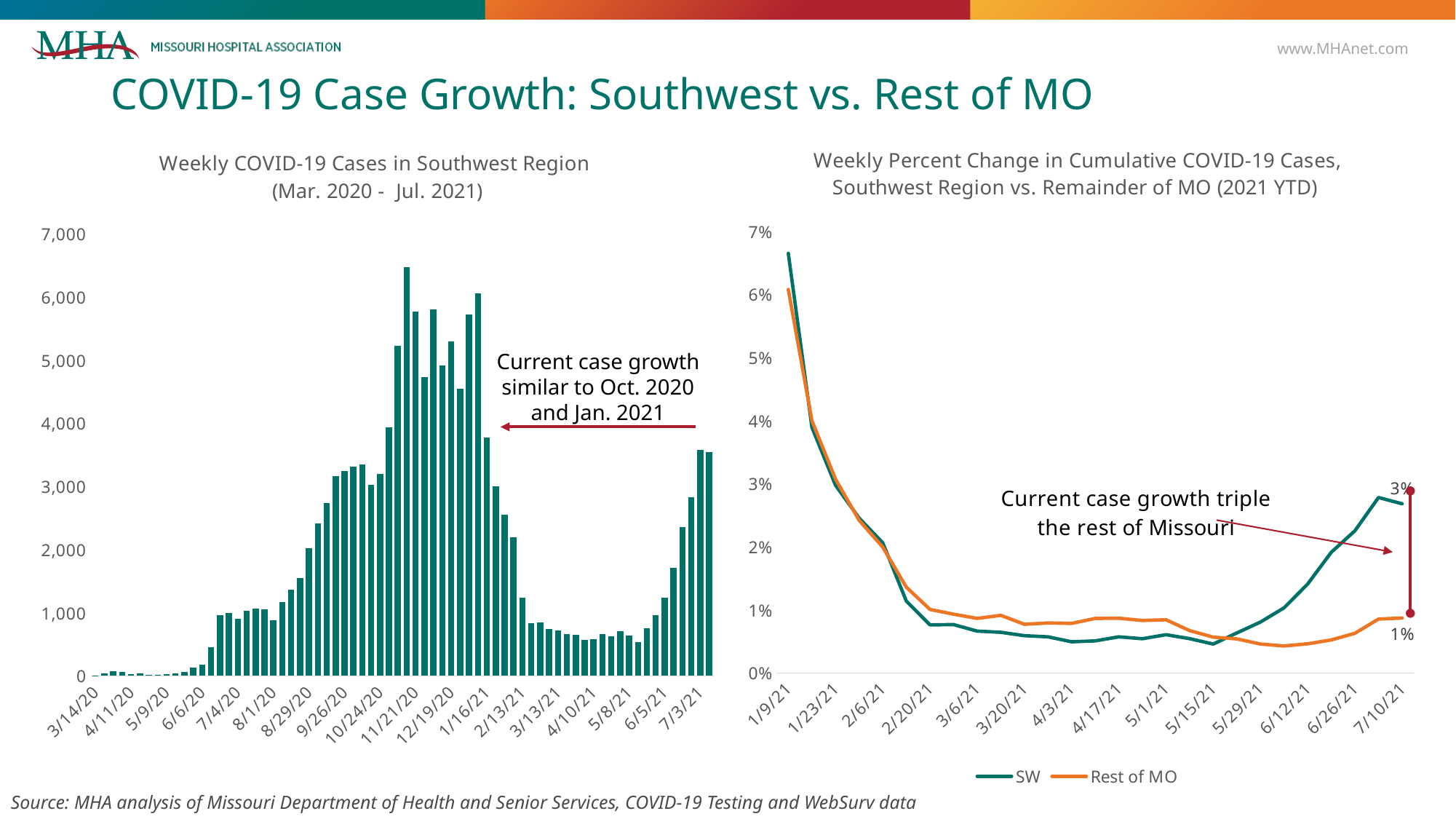
In the left chart, is the tallest bar greater or less than 6,000? greater In the right chart, what is the labeled value for Rest of MO at 7/10/21? 1% In the right chart, is the SW value at 1/9/21 greater or less than 6%? greater In the right chart, what are the two series named in the legend? SW and Rest of MO In the right chart, what is the labeled value for SW at 7/10/21? 3% In the right chart, how many series does the legend list? 2 What kind of chart is the left chart, 'Weekly COVID-19 Cases in Southwest Region'? Bar chart In the left chart, is the value for 3/14/20 greater or less than 1,000? less In the right chart, which series has the higher value at 7/10/21, SW or Rest of MO? SW What kind of chart is the right chart, 'Weekly Percent Change in Cumulative COVID-19 Cases'? Line chart In the right chart, does the SW line rise or fall between 1/9/21 and 2/20/21? Fall In the right chart, what is the difference between the labeled SW value and the labeled Rest of MO value at 7/10/21? 2%